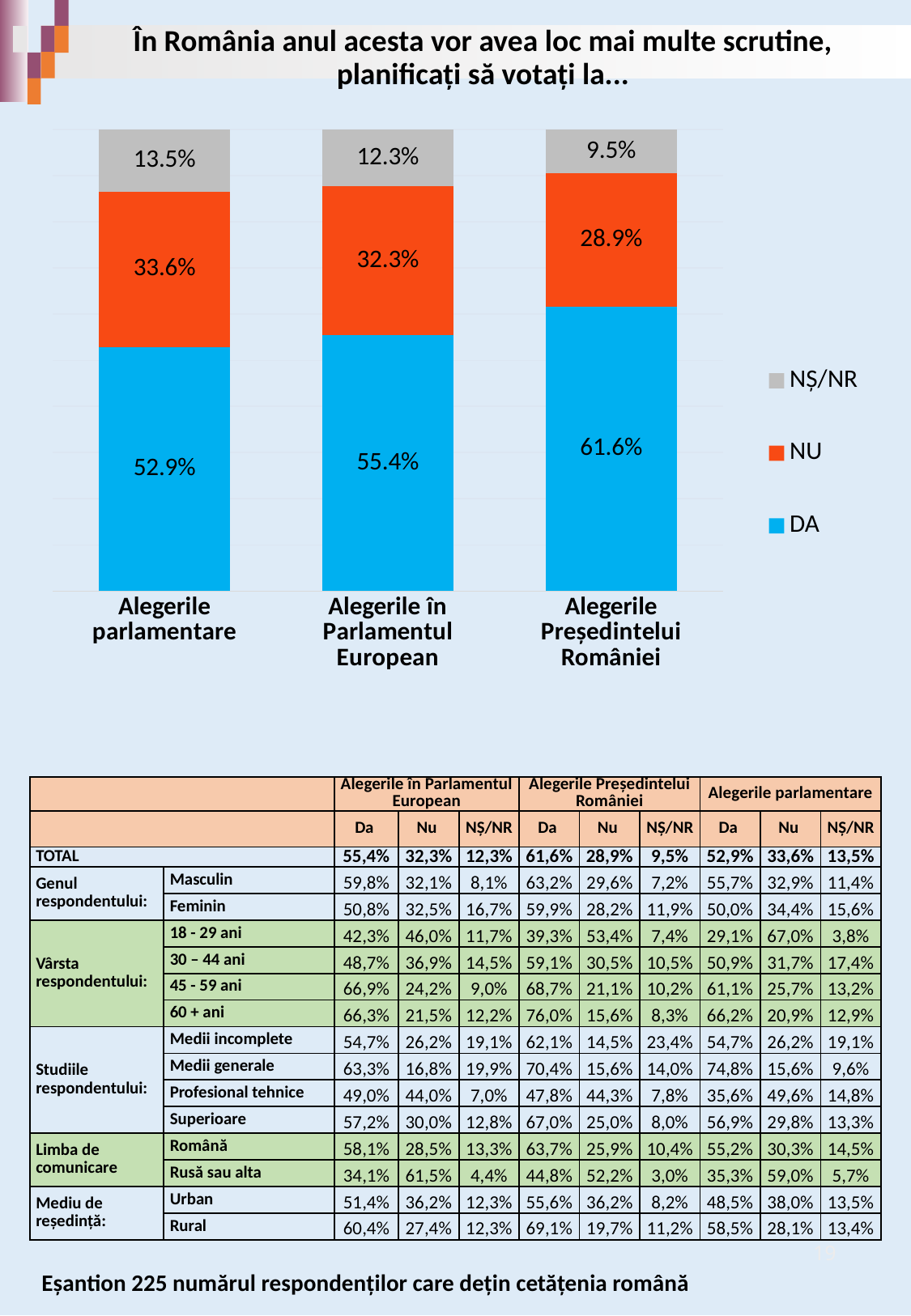
Which election has the highest DA share? Alegerile Președintelui României What is the difference between the DA values for Alegerile Președintelui României and Alegerile parlamentare? 8.7% Which election has the lowest NȘ/NR share? Alegerile Președintelui României What is the NȘ/NR value for Alegerile Președintelui României? 9.5% Which colour represents the DA series in the chart? Blue What type of chart is shown on the slide? Stacked bar chart How many series does the chart legend list? 3 Which is larger: the NU value for Alegerile parlamentare or for Alegerile în Parlamentul European? Alegerile parlamentare What is the NU value for Alegerile în Parlamentul European? 32.3% How many election categories are shown in the chart? 3 What percentage of respondents answered DA for Alegerile parlamentare? 52.9% What is the DA value for Alegerile Președintelui României? 61.6%